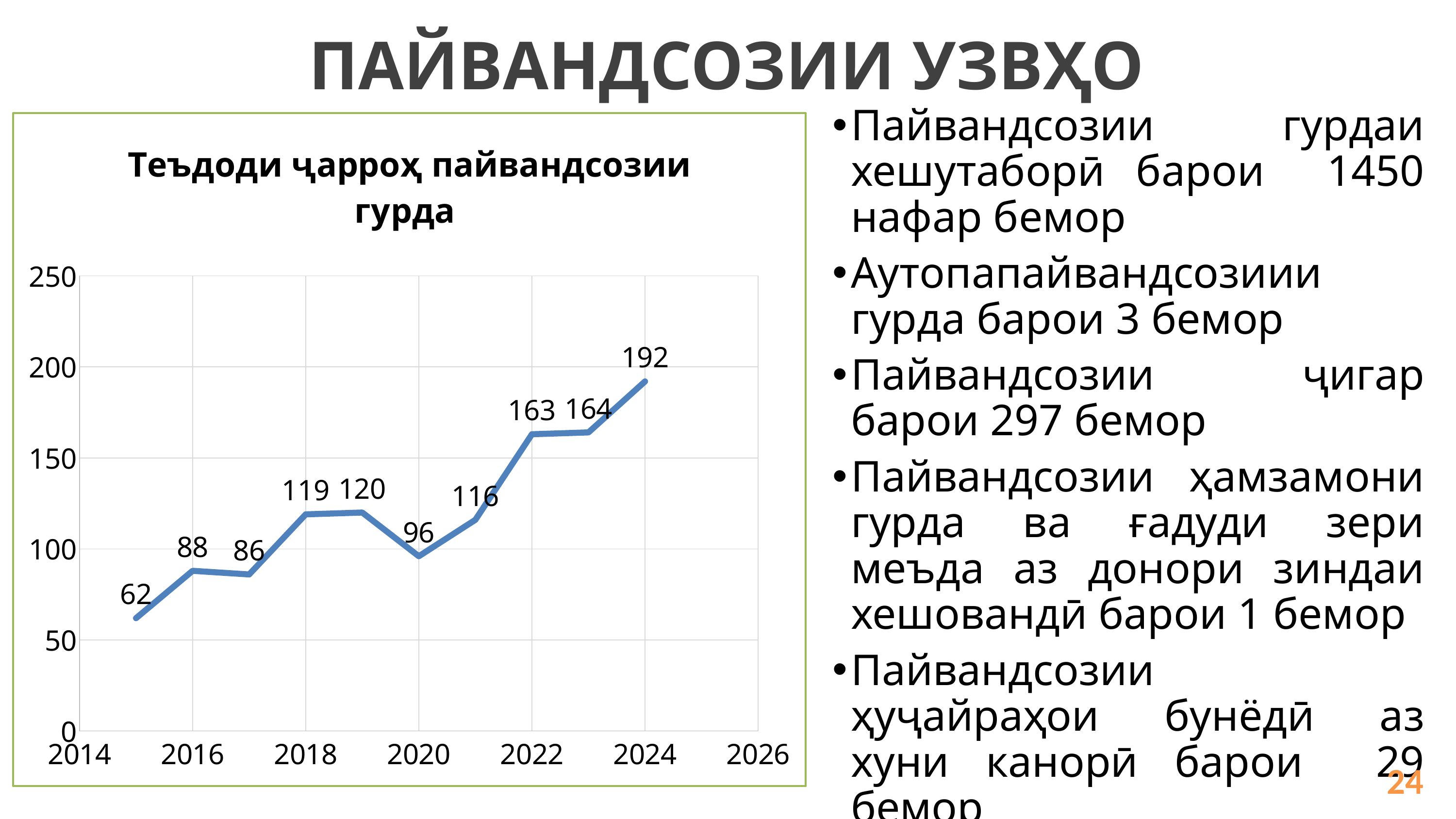
What is the highest value shown on the line? 192 What is the value plotted for 2022? 163 What is the value plotted for 2016? 88 What is the title of the chart? Теъдоди ҷарроҳ пайвандсозии гурда Overall, do the values rise or fall from the first point to the last point along the x axis? rise What is the lowest value shown on the line? 62 What is the value plotted for 2024? 192 How many data points are plotted on the line? 10 What is the difference between the highest value (192) and the lowest value (62)? 130 What is the value plotted for 2020? 96 Which year has the larger value, 2018 or 2020? 2018 What kind of chart is shown on the slide? line chart